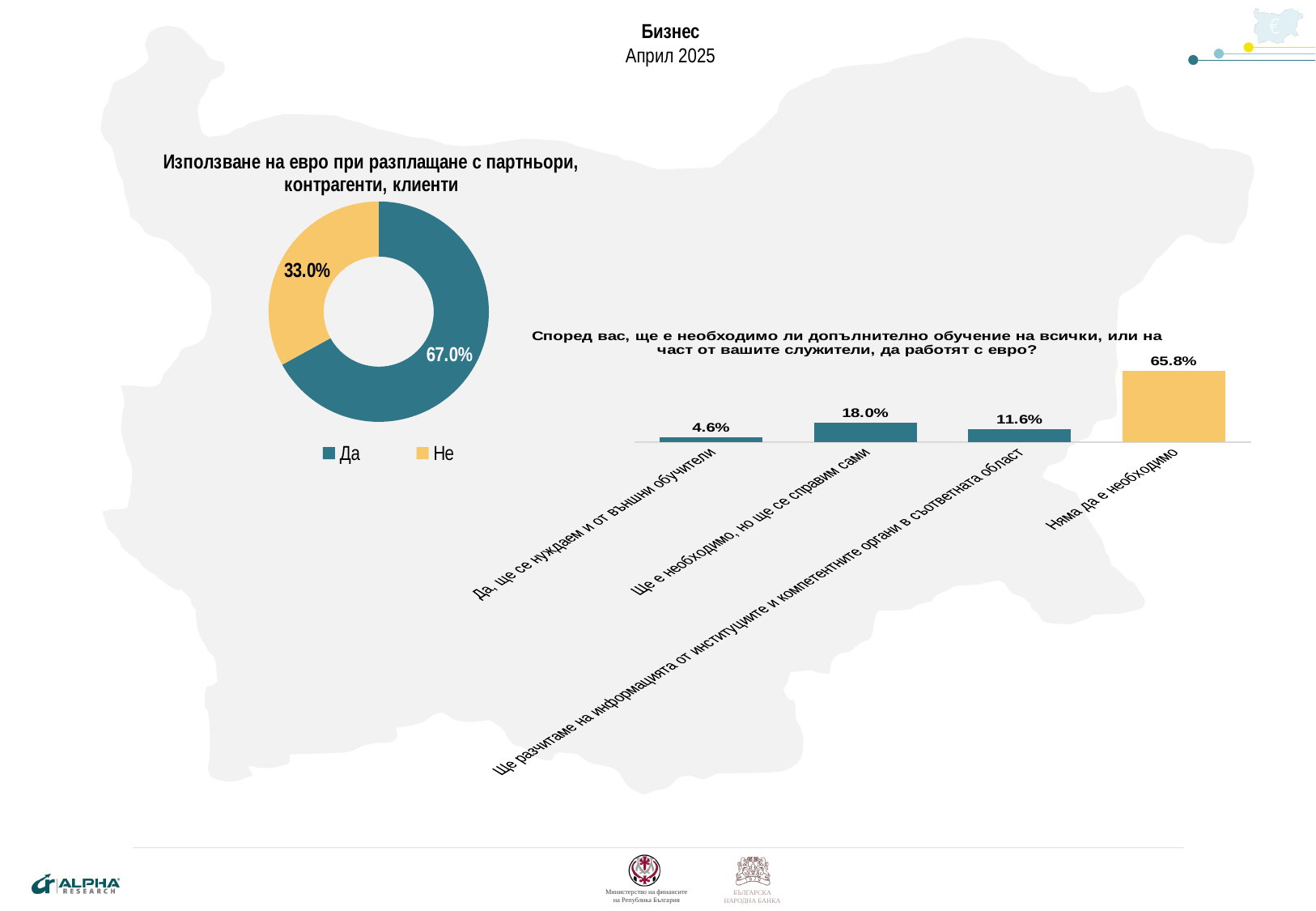
In the bar chart on the right, which category has the lowest value? Да, ще се нуждаем и от външни обучители In the donut chart 'Използване на евро при разплащане с партньори, контрагенти, клиенти', what is the value for 'Да'? 67.0% In the donut chart 'Използване на евро при разплащане с партньори, контрагенти, клиенти', what is the value for 'Не'? 33.0% In the donut chart on the left, which category has the larger share, 'Да' or 'Не'? Да How many entries does the legend of the donut chart on the left list? 2 In the bar chart 'Според вас, ще е необходимо ли допълнително обучение...', what is the value for 'Ще е необходимо, но ще се справим сами'? 18.0% In the bar chart on the right, what is the difference between 'Ще е необходимо, но ще се справим сами' and 'Ще разчитаме на информацията от институциите и компетентните органи в съответната област'? 6.4% What kind of chart is the chart on the left of the slide? Pie (donut) chart In the bar chart 'Според вас, ще е необходимо ли допълнително обучение...', what is the value for 'Няма да е необходимо'? 65.8% In the donut chart on the left, what is the difference between the 'Да' and 'Не' shares? 34.0% How many categories are shown in the bar chart on the right? 4 In the bar chart on the right, which category has the highest value? Няма да е необходимо